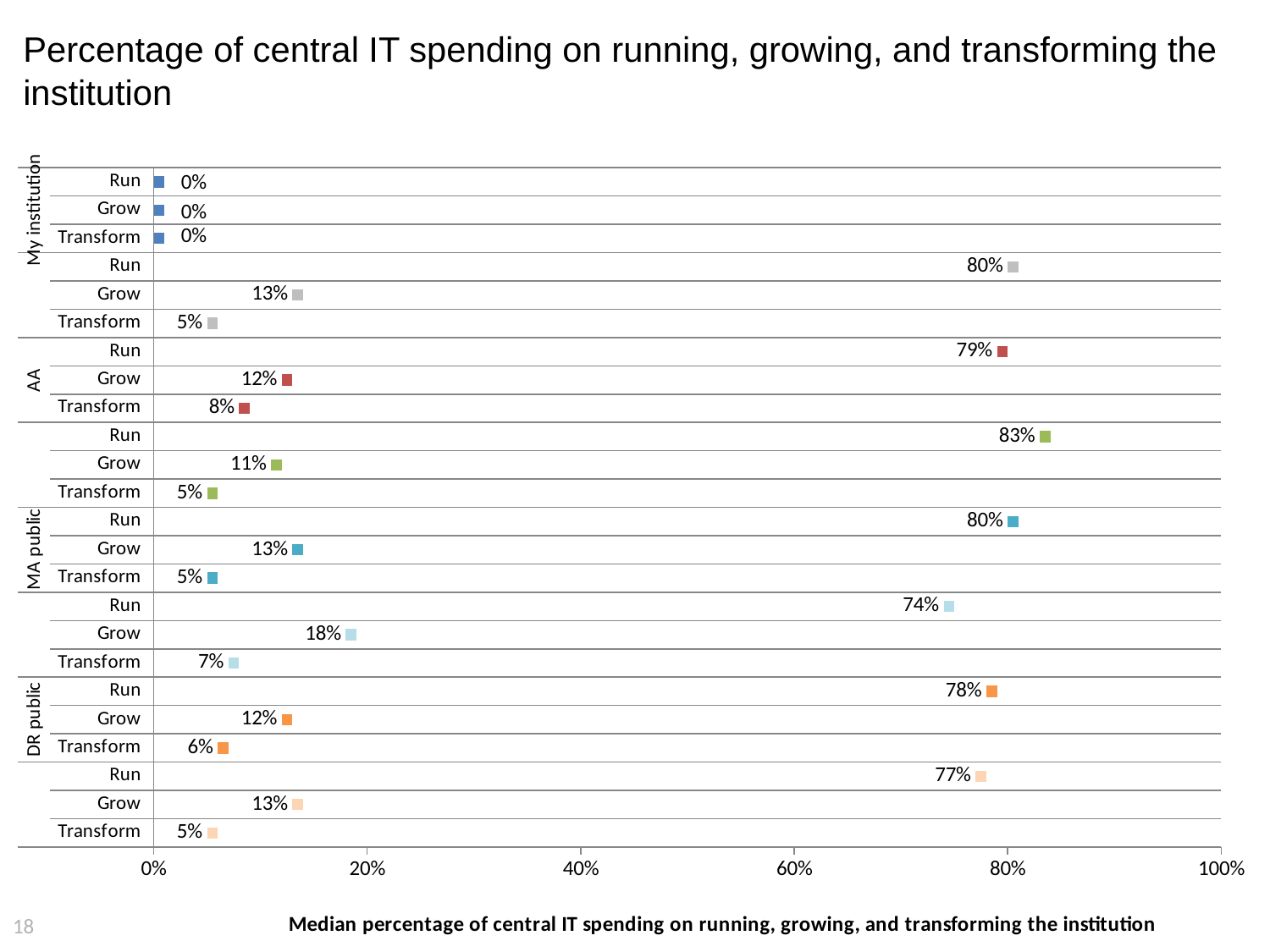
Within the MA public group, which category has the lowest value? Transform What is the difference between Run and Grow in the DR public group? 66% What is the value for Run in the AA group? 79% Within the AA group, which category has the highest value? Run Which is larger: Run for MA public or Run for DR public? Run for MA public What is the value for Run in the My institution group? 0% Is the value for Run in the AA group greater or less than 60%? greater What is the value for Grow in the MA public group? 13% What is the value for Transform in the AA group? 8% What is the value for Transform in the DR public group? 6% What is the highest tick value shown on the horizontal axis? 100% What is the difference between Run and Transform in the AA group? 71%